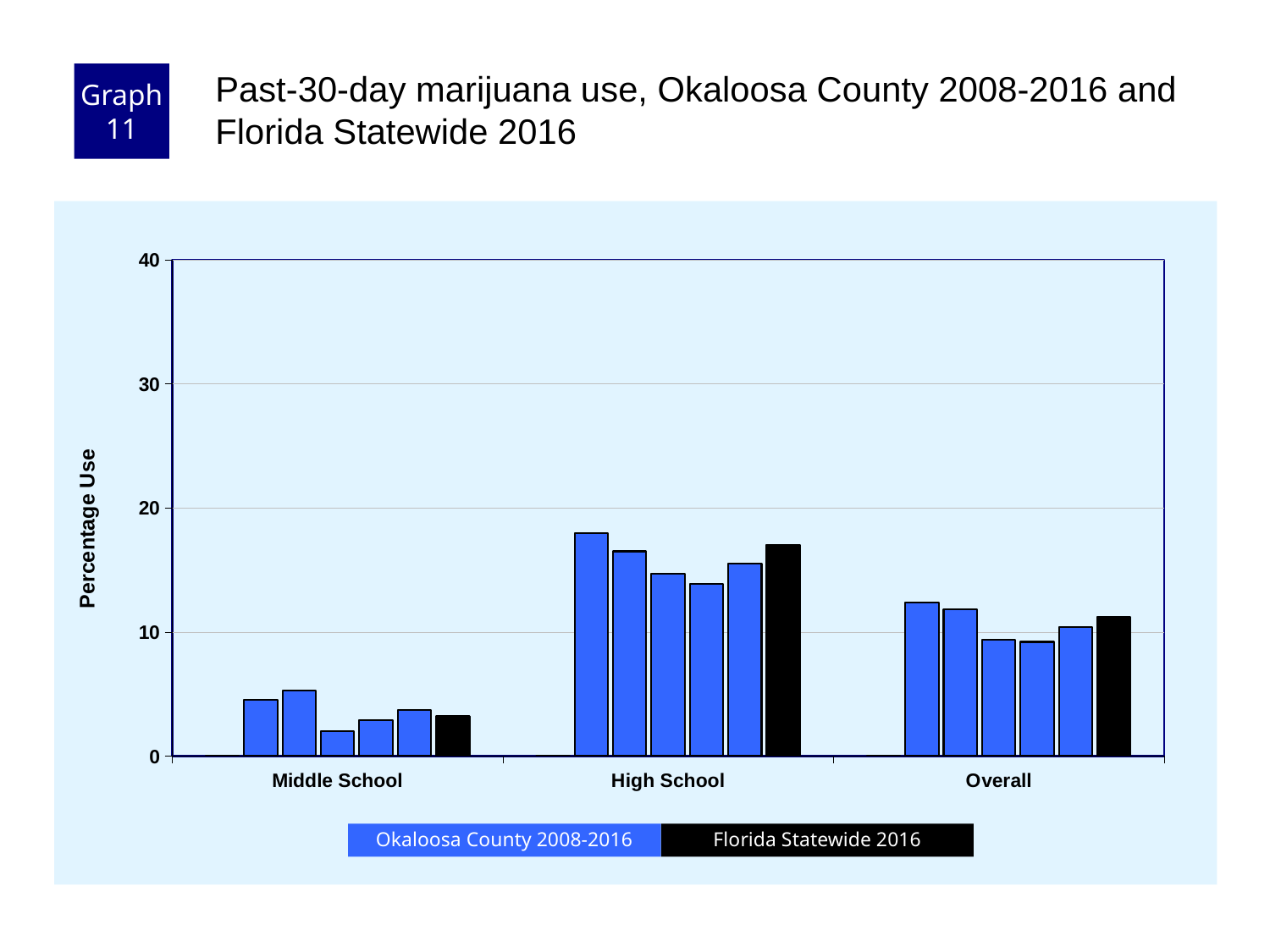
Which colour represents Florida Statewide 2016 in the legend? black Is the Florida Statewide 2016 value for Overall greater or less than 10? greater What is the label on the y axis? Percentage Use Which category has the highest Florida Statewide 2016 value? High School How many categories are shown on the x axis? 3 Is the Florida Statewide 2016 value for Middle School greater or less than 10? less How many series does the legend list? 2 Which is larger, the Florida Statewide 2016 value for High School or for Overall? High School Is the Florida Statewide 2016 value for High School greater or less than 20? less Which category has the lowest Florida Statewide 2016 value? Middle School What kind of chart is shown on the slide? bar chart